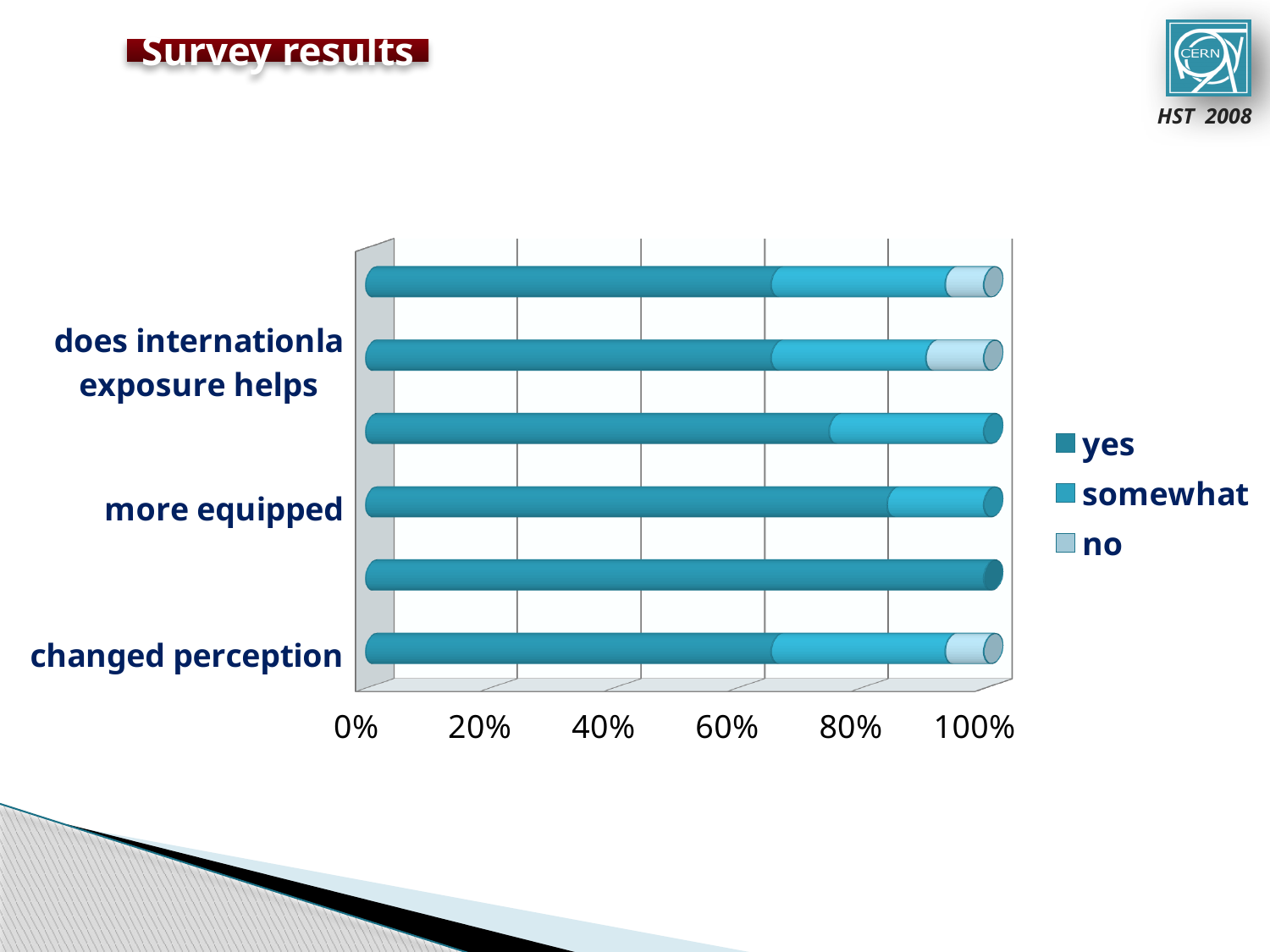
How many series does the legend list? 3 Is the 'yes' share for 'changed perception' greater or less than 80%? less Is the 'no' share for 'changed perception' greater or less than 20%? less Which has the larger 'yes' share: 'more equipped' or 'changed perception'? more equipped Is the 'yes' share for 'more equipped' greater or less than 80%? greater What kind of chart is shown on the slide? stacked bar chart What are the series names listed in the legend? yes, somewhat, no What is the title of the slide containing the chart? Survey results How many bars are plotted in the chart? 6 Among the labelled categories, which has the highest 'yes' share? more equipped